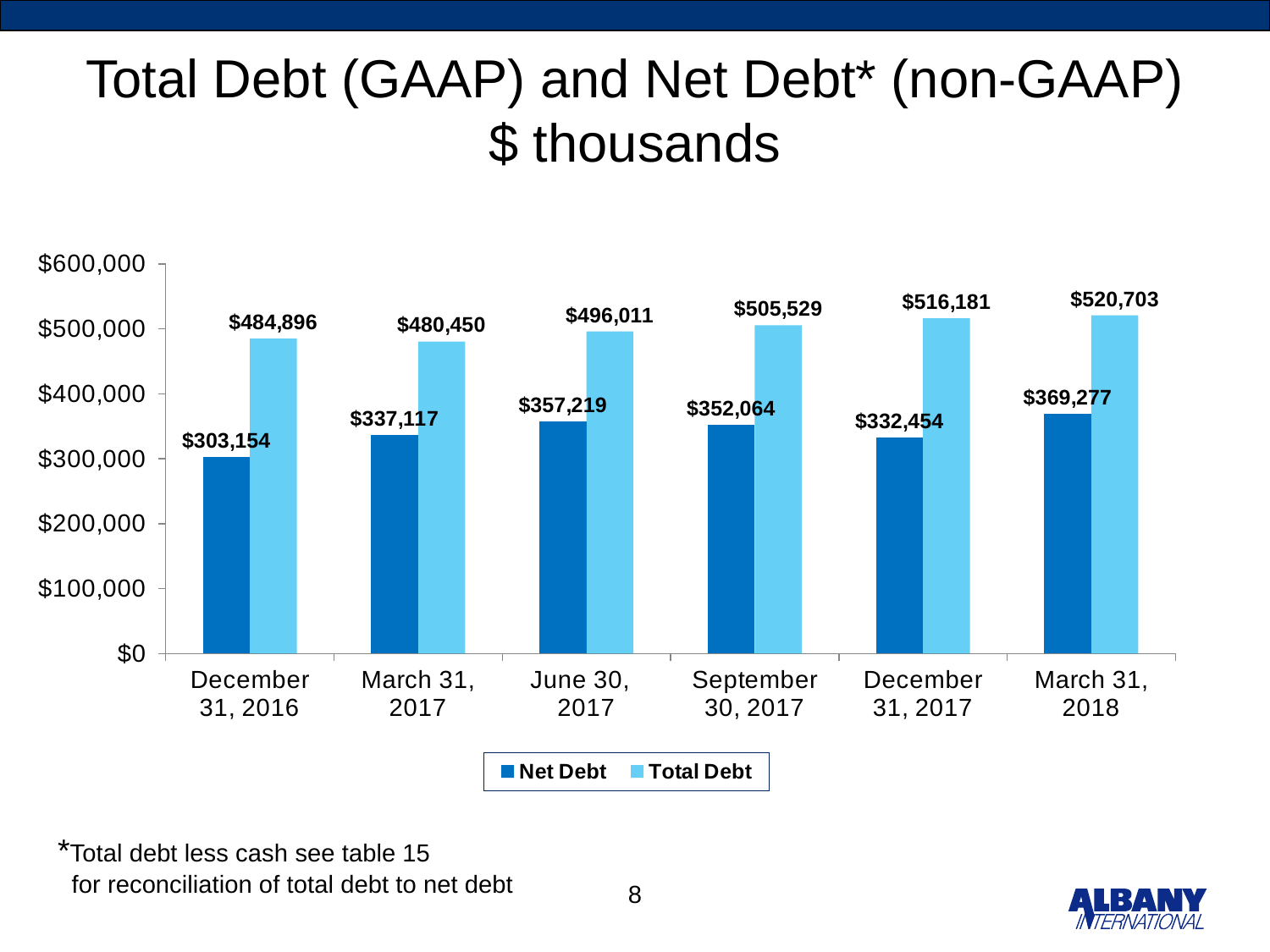
What is the Total Debt value for September 30, 2017? $505,529 Which date has the highest Net Debt? March 31, 2018 Is the Net Debt value for March 31, 2018 greater or less than $400,000? less What kind of chart is shown on the slide? bar chart What is the Total Debt value for March 31, 2018? $520,703 Does Total Debt rise or fall from June 30, 2017 to March 31, 2018? rise How many series does the legend list? 2 What is the Net Debt value for December 31, 2016? $303,154 Which date has the lowest Total Debt? March 31, 2017 How many dates are shown on the x axis? 6 Is Net Debt higher on June 30, 2017 or on December 31, 2017? June 30, 2017 What is the difference between Total Debt and Net Debt on March 31, 2018? $151,426